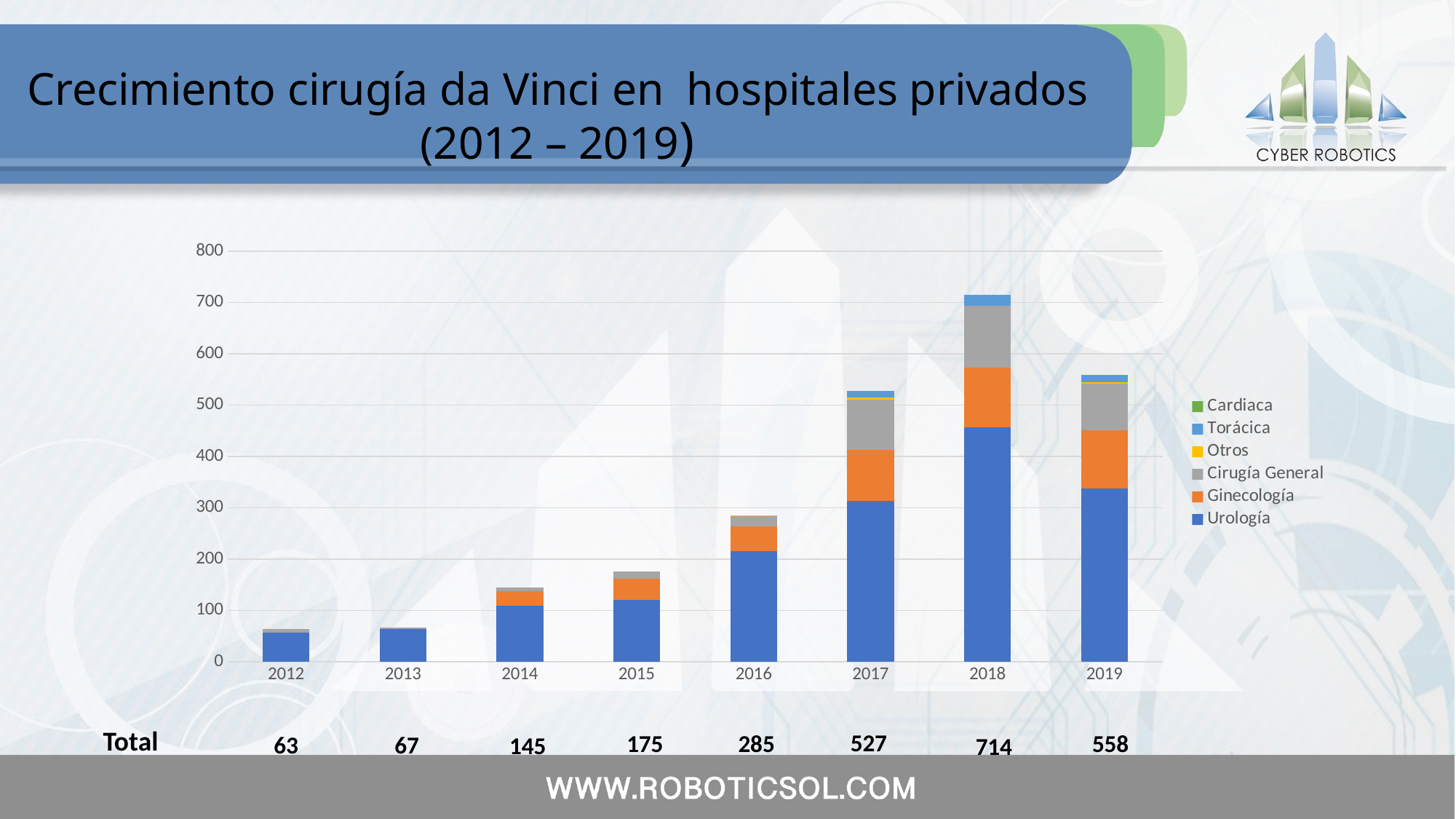
How many series does the legend list? 6 Is the Urología value for 2018 greater or less than 400? greater Which series is shown in blue at the bottom of each bar? Urología What is the total for 2016? 285 What is the total for 2012? 63 Which year has the highest total? 2018 Which year has a larger total, 2017 or 2019? 2019 How many years are shown on the x axis? 8 What is the difference between the totals for 2018 and 2019? 156 What type of chart is shown on the slide? Stacked bar chart What is the total for 2018? 714 Which year has the lowest total? 2012